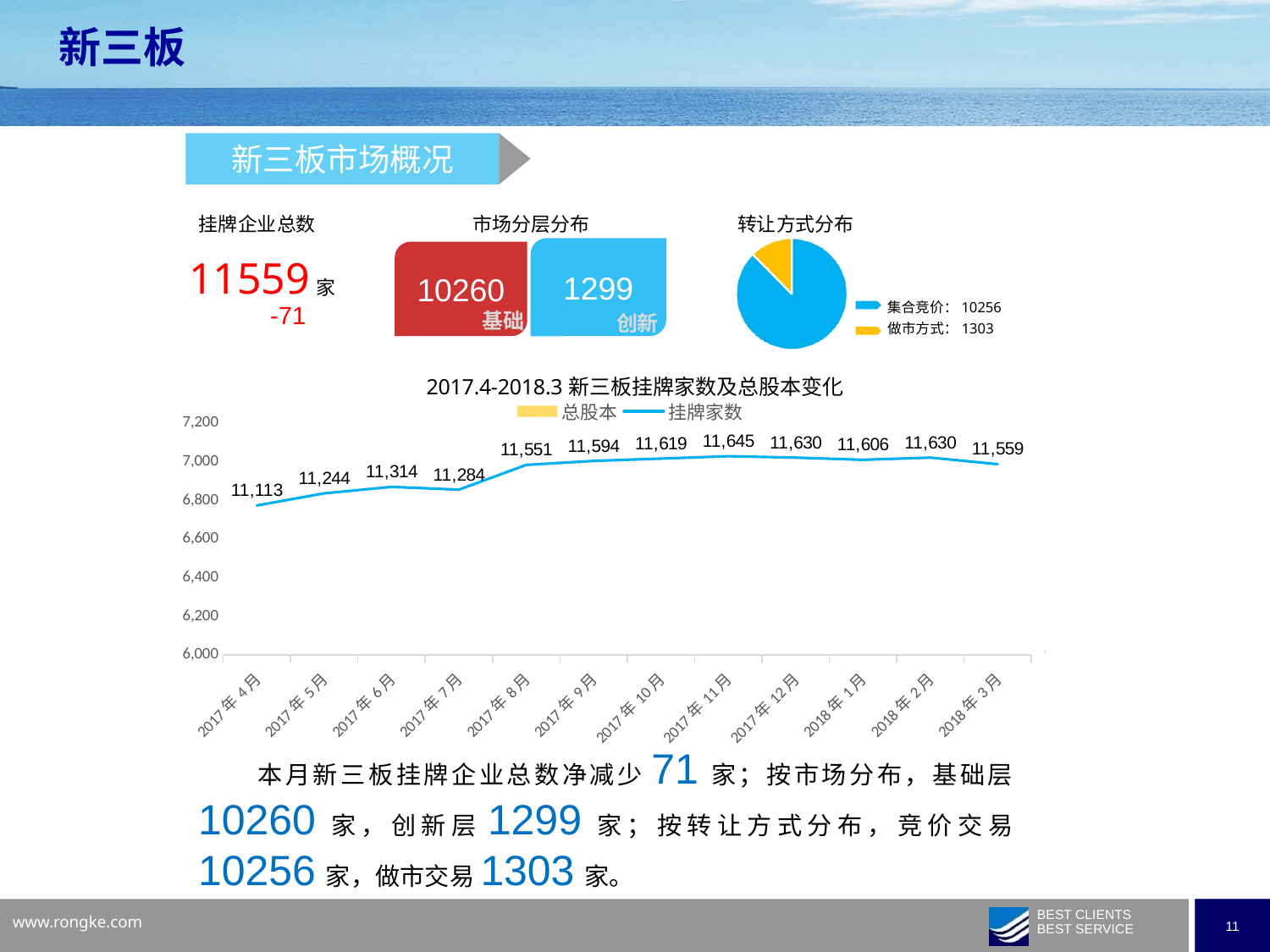
In the line chart titled 2017.4-2018.3 新三板挂牌家数及总股本变化, what is the 挂牌家数 value for 2018年3月? 11,559 In the line chart titled 2017.4-2018.3 新三板挂牌家数及总股本变化, how many months are plotted on the x axis? 12 In the line chart titled 2017.4-2018.3 新三板挂牌家数及总股本变化, which month has the highest 挂牌家数? 2017年11月 What kind of chart is the one titled 转让方式分布? pie chart In the pie chart titled 转让方式分布, which category has the larger slice? 集合竞价 In the chart titled 2017.4-2018.3 新三板挂牌家数及总股本变化, does the 挂牌家数 rise or fall from 2017年4月 to 2017年11月? rise In the line chart titled 2017.4-2018.3 新三板挂牌家数及总股本变化, is the 挂牌家数 for 2017年7月 larger or smaller than for 2017年6月? smaller In the line chart titled 2017.4-2018.3 新三板挂牌家数及总股本变化, what is the difference in 挂牌家数 between 2018年2月 and 2018年3月? 71 In the pie chart titled 转让方式分布, what is the value for 做市方式? 1303 In the line chart titled 2017.4-2018.3 新三板挂牌家数及总股本变化, how many series does the legend list? 2 In the line chart titled 2017.4-2018.3 新三板挂牌家数及总股本变化, which month has the lowest 挂牌家数? 2017年4月 In the line chart titled 2017.4-2018.3 新三板挂牌家数及总股本变化, what is the 挂牌家数 value for 2017年4月? 11,113